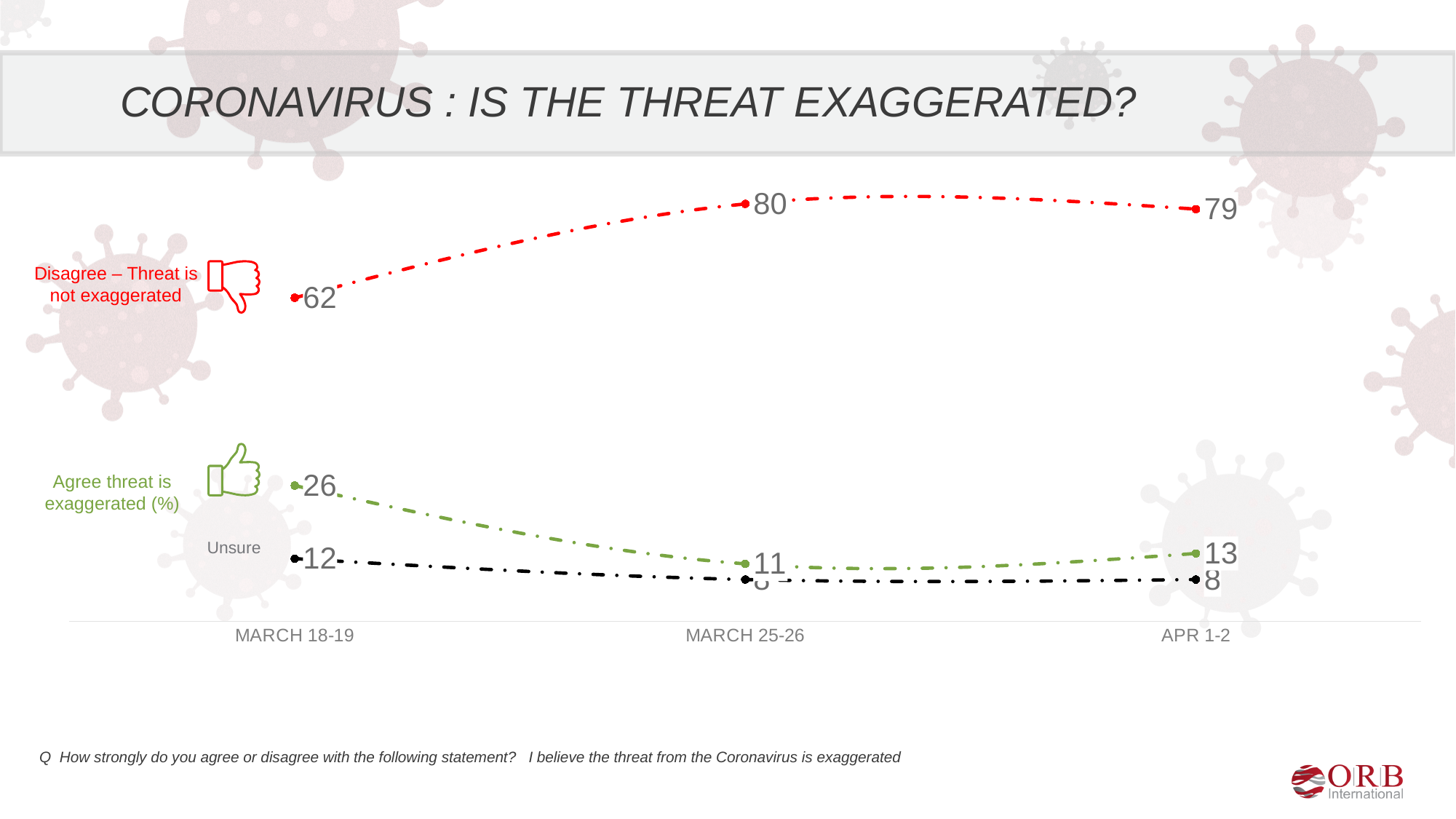
What kind of chart is shown on the slide? line chart Does the 'Agree threat is exaggerated' line rise or fall from March 18-19 to March 25-26? fall At which date is the 'Agree threat is exaggerated' value lowest? March 25-26 How many dates are shown on the x axis? 3 Which is larger at Apr 1-2: 'Agree threat is exaggerated' or 'Unsure'? Agree threat is exaggerated What is the value for 'Disagree – Threat is not exaggerated' at Apr 1-2? 79 What is the difference between the 'Disagree' values at March 25-26 and March 18-19? 18 What is the value for 'Unsure' at Apr 1-2? 8 How many series are plotted on the chart? 3 What is the value for 'Disagree – Threat is not exaggerated' at March 25-26? 80 At which date is the 'Disagree – Threat is not exaggerated' value highest? March 25-26 What is the value for 'Agree threat is exaggerated' at March 18-19? 26